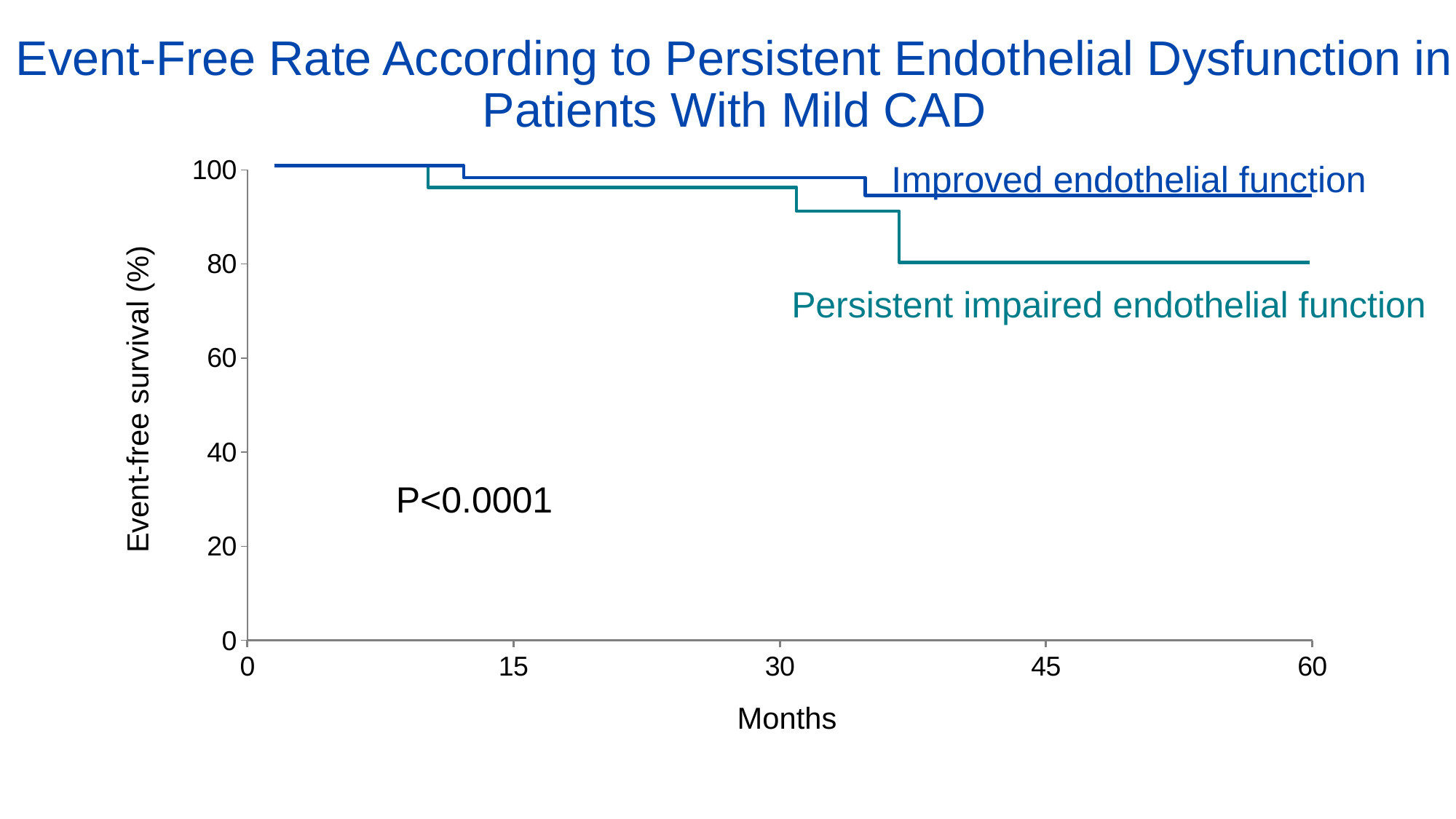
Is the event-free survival for Improved endothelial function at 60 months greater or less than 80? greater Which series has the lowest event-free survival at the end of follow-up? Persistent impaired endothelial function How many downward steps does the Improved endothelial function line show? 2 What is the title of the chart? Event-Free Rate According to Persistent Endothelial Dysfunction in Patients With Mild CAD What P value is printed on the chart? P<0.0001 Is the event-free survival for Persistent impaired endothelial function at 60 months greater or less than 90? less At 60 months, which series has the higher event-free survival: Improved endothelial function or Persistent impaired endothelial function? Improved endothelial function Do the event-free survival values rise or fall as months increase? fall What kind of chart is shown on the slide? line chart How many downward steps does the Persistent impaired endothelial function line show? 3 How many series are plotted on the chart? 2 Is the event-free survival for Persistent impaired endothelial function at 20 months greater or less than 80? greater